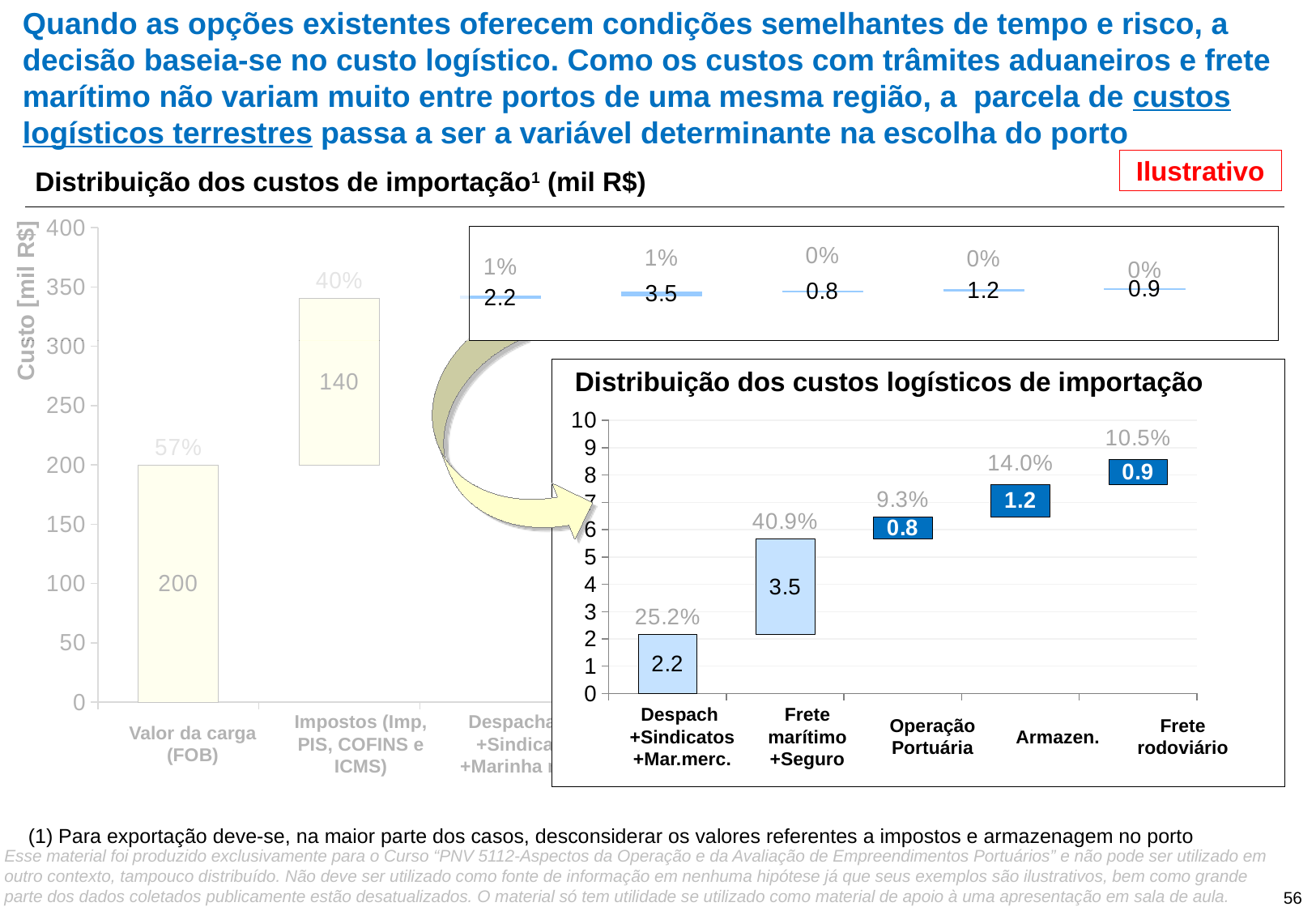
In the chart 'Distribuição dos custos logísticos de importação', what is the value for Frete marítimo+Seguro? 3.5 In the chart 'Distribuição dos custos logísticos de importação', what percentage is shown for Despach+Sindicatos+Mar.merc.? 25.2% What kind of chart is 'Distribuição dos custos logísticos de importação'? Bar chart In the chart 'Distribuição dos custos logísticos de importação', which category has the highest value? Frete marítimo+Seguro How many categories are shown on the x axis of the chart 'Distribuição dos custos logísticos de importação'? 5 In the chart 'Distribuição dos custos de importação¹ (mil R$)', what is the value for Valor da carga (FOB)? 200 In the chart 'Distribuição dos custos logísticos de importação', what is the value for Armazen.? 1.2 In the chart 'Distribuição dos custos de importação¹ (mil R$)', what percentage is shown for Impostos (Imp, PIS, COFINS e ICMS)? 40% In the chart 'Distribuição dos custos logísticos de importação', what is the difference between the values for Frete marítimo+Seguro and Despach+Sindicatos+Mar.merc.? 1.3 In the chart 'Distribuição dos custos logísticos de importação', which category has the lowest value? Operação Portuária In the chart 'Distribuição dos custos logísticos de importação', which is larger: the value for Armazen. or the value for Frete rodoviário? Armazen. In the chart 'Distribuição dos custos logísticos de importação', what percentage is shown for Frete rodoviário? 10.5%